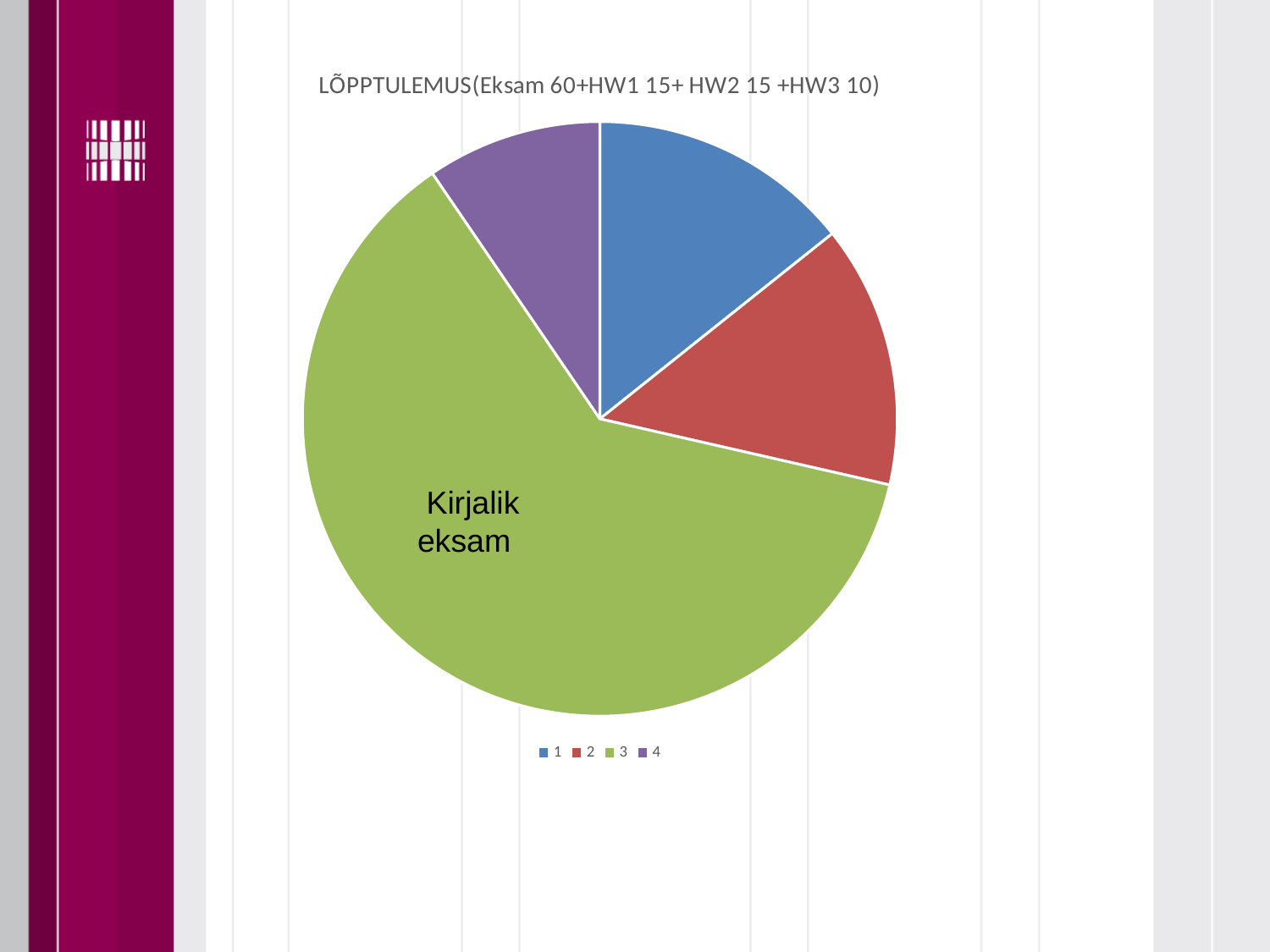
Which category has the smallest slice in the pie chart? 4 What kind of chart is shown on the slide? pie chart Which slice is larger in the pie chart, category 1 or category 4? 1 What is the title of the pie chart? LÕPPTULEMUS(Eksam 60+HW1 15+ HW2 15 +HW3 10) Which slice is larger in the pie chart, category 4 or category 3? 3 How many slices does the pie chart have? 4 Which slice is larger in the pie chart, category 3 or category 1? 3 Does the largest slice of the pie chart take up more or less than half of the pie? more Which category has the largest slice in the pie chart? 3 What text label is written inside the largest slice of the pie chart? Kirjalik eksam How many entries does the legend of the pie chart list? 4